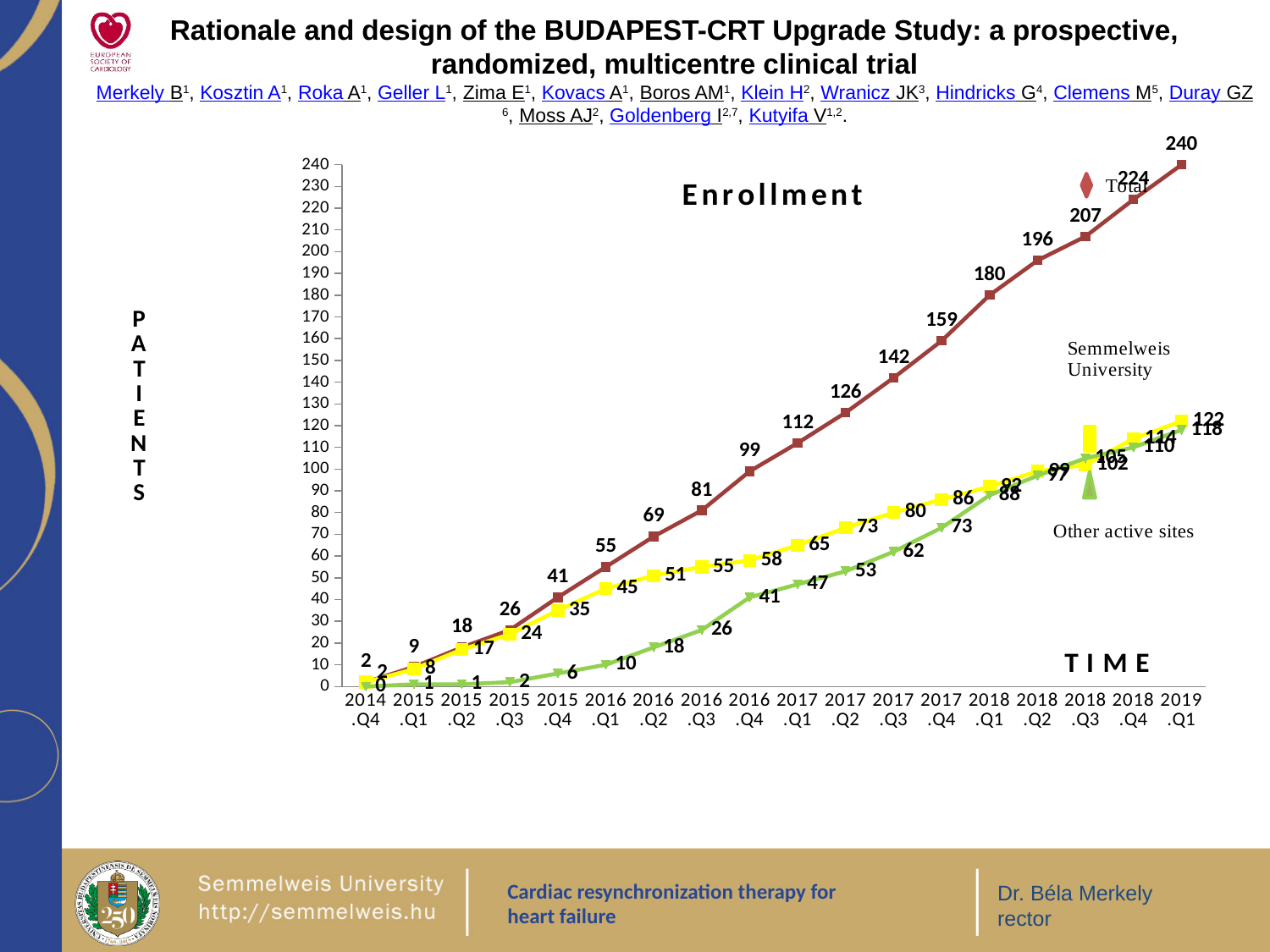
Does the Total enrollment line rise or fall over time? rise What is the Total enrollment value at 2017.Q1? 112 What is the Other active sites value at 2016.Q4? 41 How many series are plotted on the chart? 3 By how much did the Total enrollment increase from 2017.Q4 to 2018.Q1? 21 How many time points are shown on the x axis? 18 What is the Total enrollment value at 2019.Q1? 240 What is the title of the chart? Enrollment At 2016.Q2, which is larger: Semmelweis University or Other active sites? Semmelweis University What kind of chart is shown on the slide? line chart Is the Other active sites value at 2017.Q2 greater or less than 50? greater What is the Semmelweis University value at 2017.Q3? 80